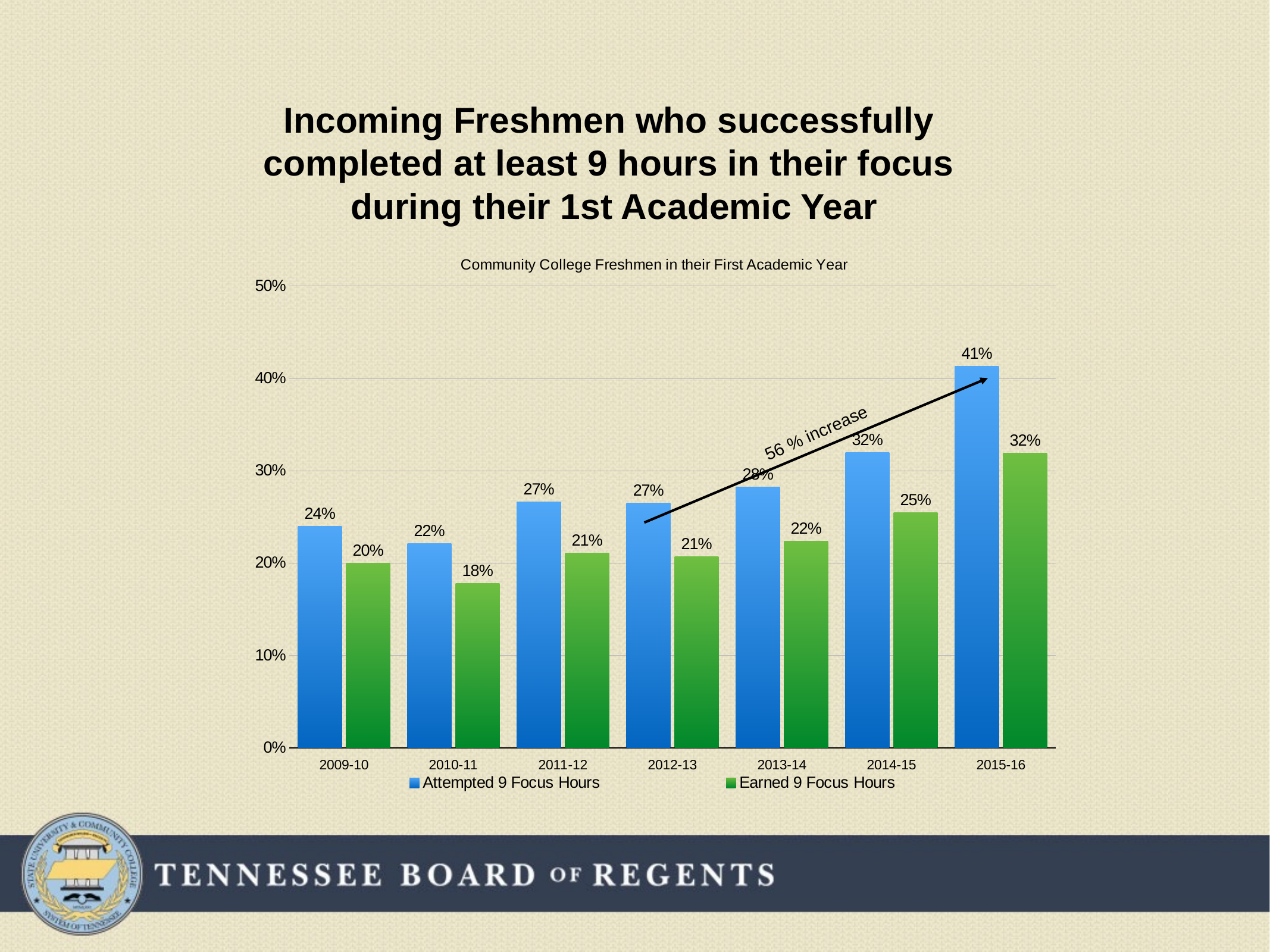
Which academic year has the highest value for Attempted 9 Focus Hours? 2015-16 What is the value for Attempted 9 Focus Hours in 2015-16? 41% What is the value for Attempted 9 Focus Hours in 2009-10? 24% What is the difference between Attempted 9 Focus Hours and Earned 9 Focus Hours in 2015-16? 9% How many series does the legend list? 2 Which is larger in 2011-12: Attempted 9 Focus Hours or Earned 9 Focus Hours? Attempted 9 Focus Hours What is the value for Earned 9 Focus Hours in 2010-11? 18% What is the value for Earned 9 Focus Hours in 2014-15? 25% What is the title of the chart? Community College Freshmen in their First Academic Year How many academic years are shown on the x axis? 7 Which academic year has the lowest value for Earned 9 Focus Hours? 2010-11 What kind of chart is shown on the slide? bar chart